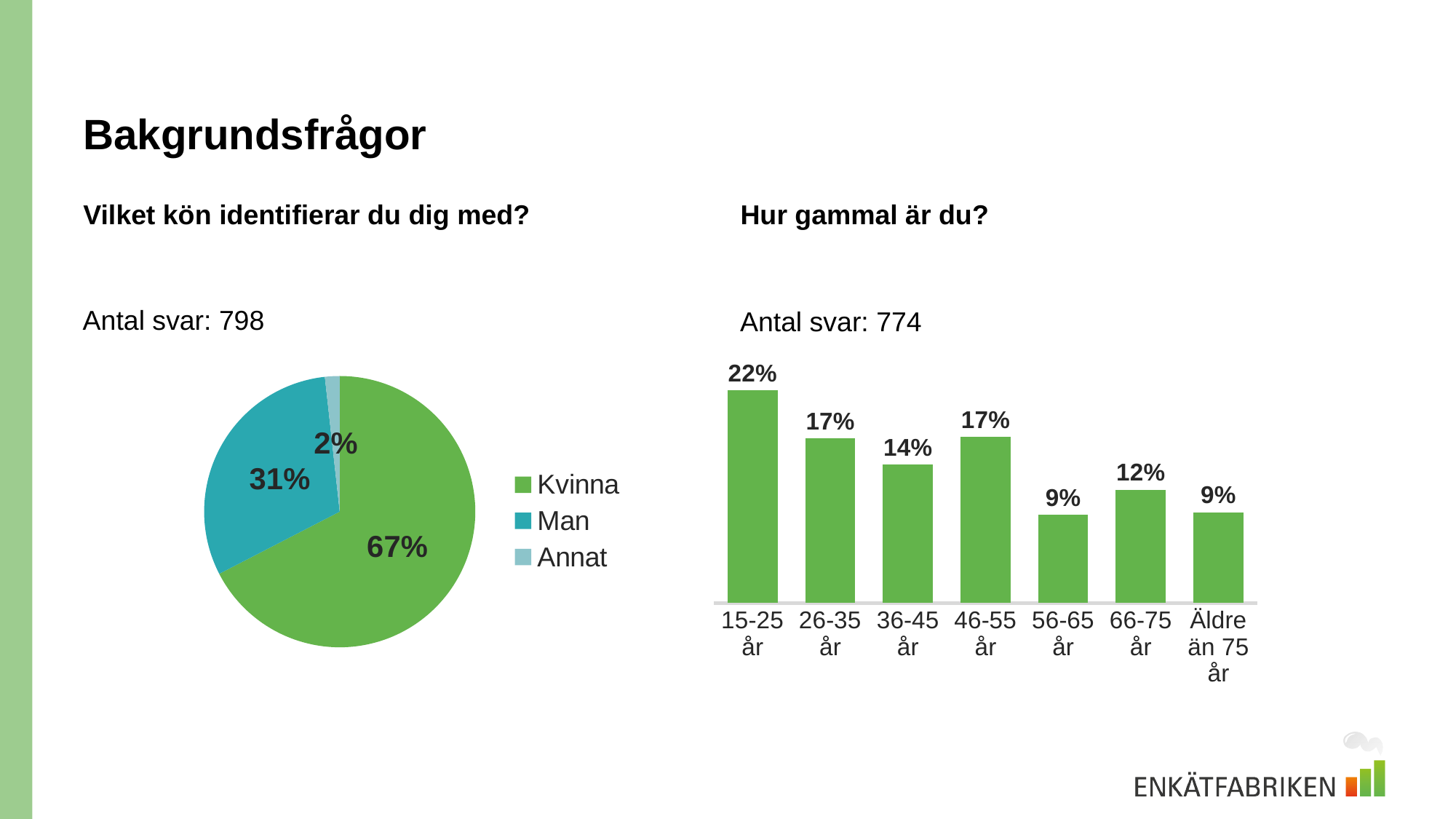
In the pie chart 'Vilket kön identifierar du dig med?', how many categories does the legend list? 3 In the bar chart 'Hur gammal är du?', what is the difference between 15-25 år and 46-55 år? 5% In the bar chart 'Hur gammal är du?', what is the value for 15-25 år? 22% In the pie chart 'Vilket kön identifierar du dig med?', what is the difference between the Kvinna and Man shares? 36% In the pie chart 'Vilket kön identifierar du dig med?', which category has the smallest slice? Annat In the bar chart 'Hur gammal är du?', which age group has the highest value? 15-25 år In the bar chart 'Hur gammal är du?', which is larger, 66-75 år or 56-65 år? 66-75 år In the pie chart 'Vilket kön identifierar du dig med?', what share is Man? 31% In the pie chart 'Vilket kön identifierar du dig med?', what share is Kvinna? 67% In the bar chart 'Hur gammal är du?', how many age groups are shown? 7 In the bar chart 'Hur gammal är du?', what is the value for 36-45 år? 14% What kind of chart is used for 'Hur gammal är du?'? Bar chart